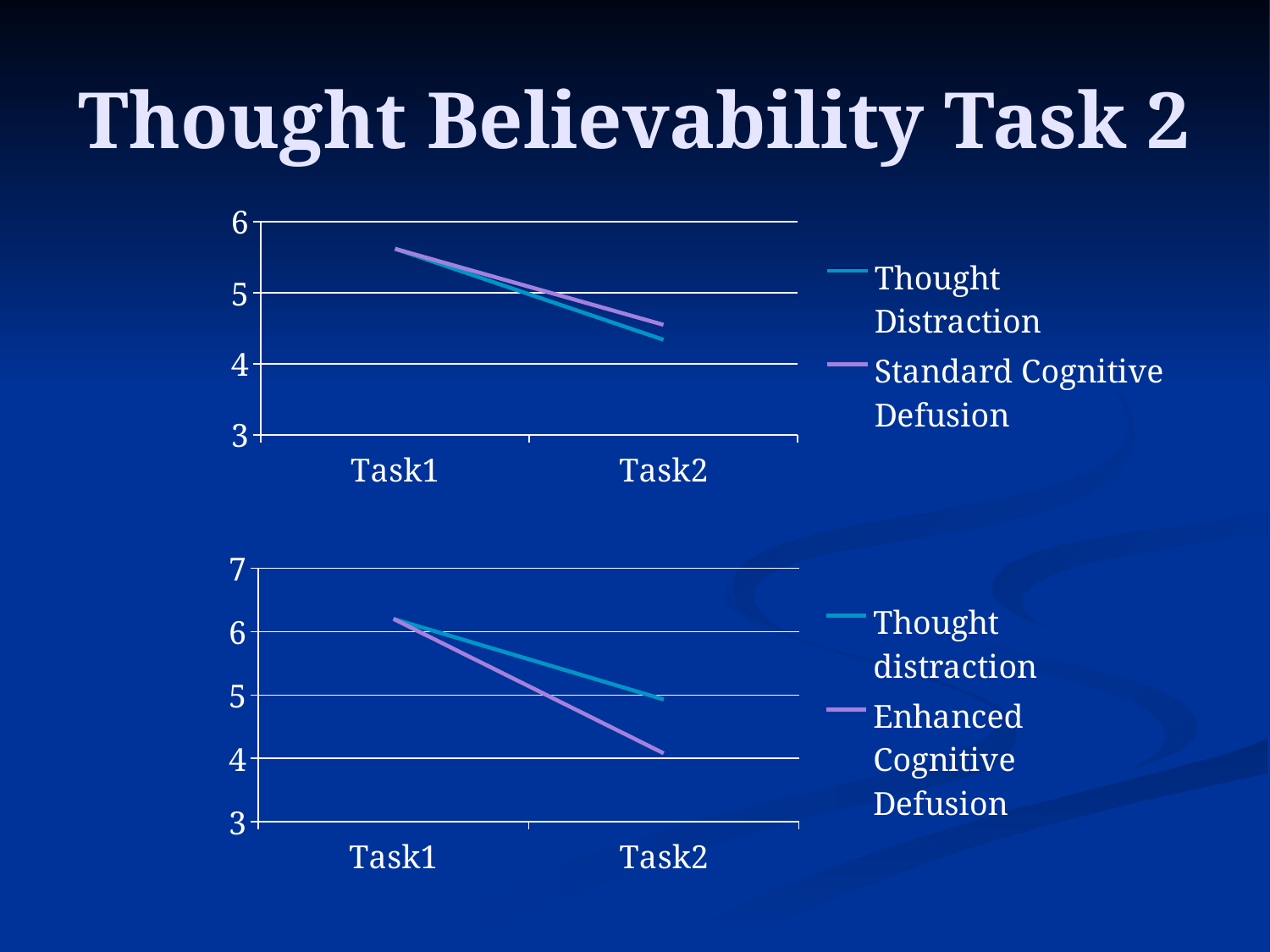
What is the title of the slide containing the two charts? Thought Believability Task 2 In the top chart, does the Thought Distraction line rise or fall from Task1 to Task2? fall In the bottom chart, which series has the higher value at Task2, Thought distraction or Enhanced Cognitive Defusion? Thought distraction In the top chart, is the value for Thought Distraction at Task2 greater or less than 5? less In the bottom chart, is the value for Thought distraction at Task1 greater or less than 5? greater In the bottom chart, does the Enhanced Cognitive Defusion line rise or fall from Task1 to Task2? fall How many series does the legend of the bottom chart list? 2 What are the two series listed in the legend of the top chart? Thought Distraction and Standard Cognitive Defusion How many categories are shown on the x axis of the top chart? 2 In the top chart, is the value for Standard Cognitive Defusion at Task1 greater or less than 5? greater What kind of chart is the top chart on the slide? line chart